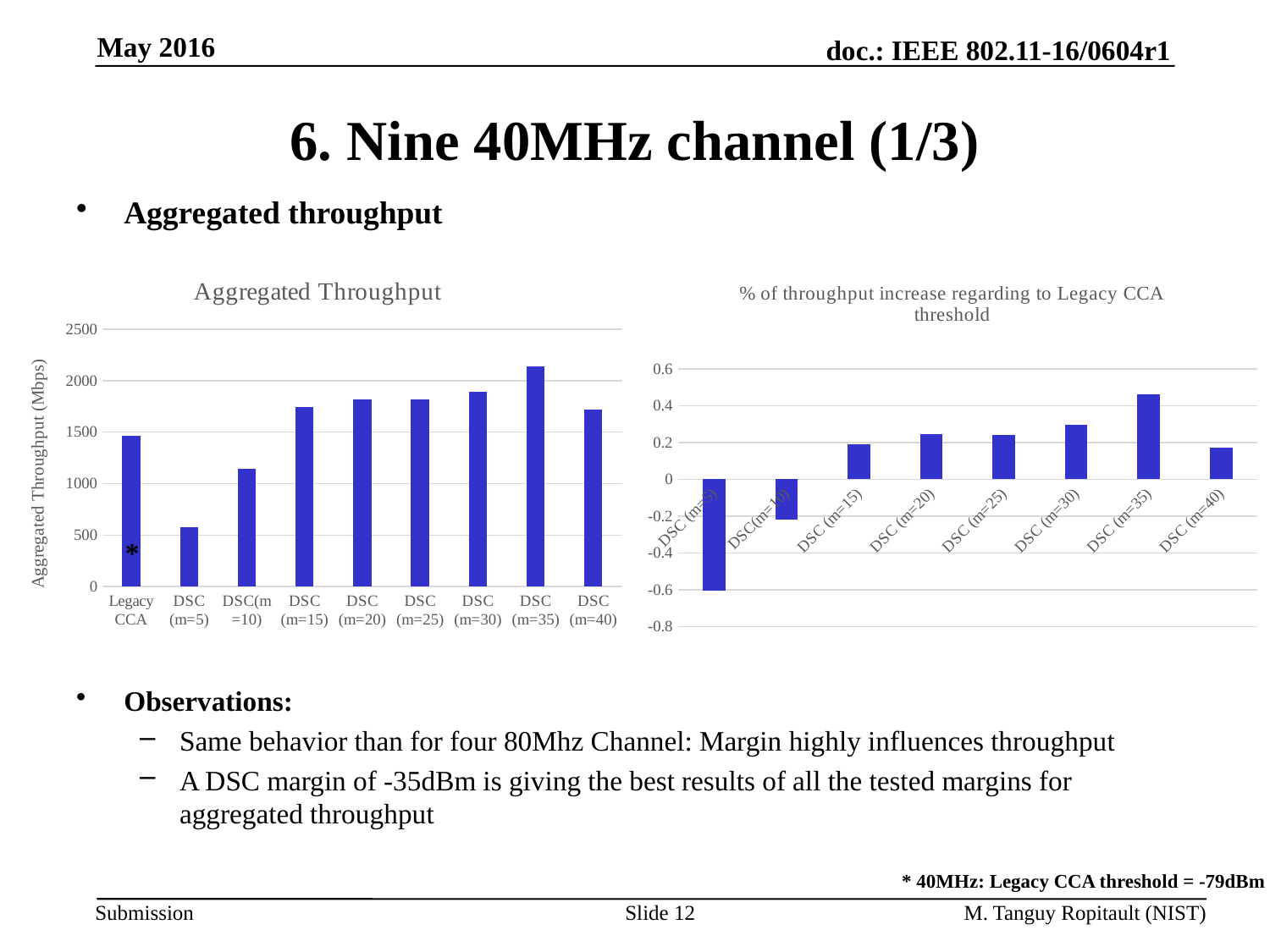
In the Aggregated Throughput chart, what is the label of the vertical axis? Aggregated Throughput (Mbps) In the Aggregated Throughput chart, how many categories are shown on the x axis? 9 In the Aggregated Throughput chart, which category has the highest aggregated throughput? DSC (m=35) In the '% of throughput increase regarding to Legacy CCA threshold' chart, is the value for DSC (m=10) greater or less than 0? less What kind of chart is the Aggregated Throughput chart on the left? bar chart In the Aggregated Throughput chart, is the value for DSC (m=35) greater or less than 2000? greater In the chart on the right, '% of throughput increase regarding to Legacy CCA threshold', how many categories are shown? 8 In the Aggregated Throughput chart, is the value for DSC (m=40) greater or less than 2000? less In the '% of throughput increase regarding to Legacy CCA threshold' chart, which category has the lowest value? DSC (m=5) In the Aggregated Throughput chart, which category has the lowest aggregated throughput? DSC (m=5) In the Aggregated Throughput chart, which is larger, the value for Legacy CCA or the value for DSC (m=40)? DSC (m=40)